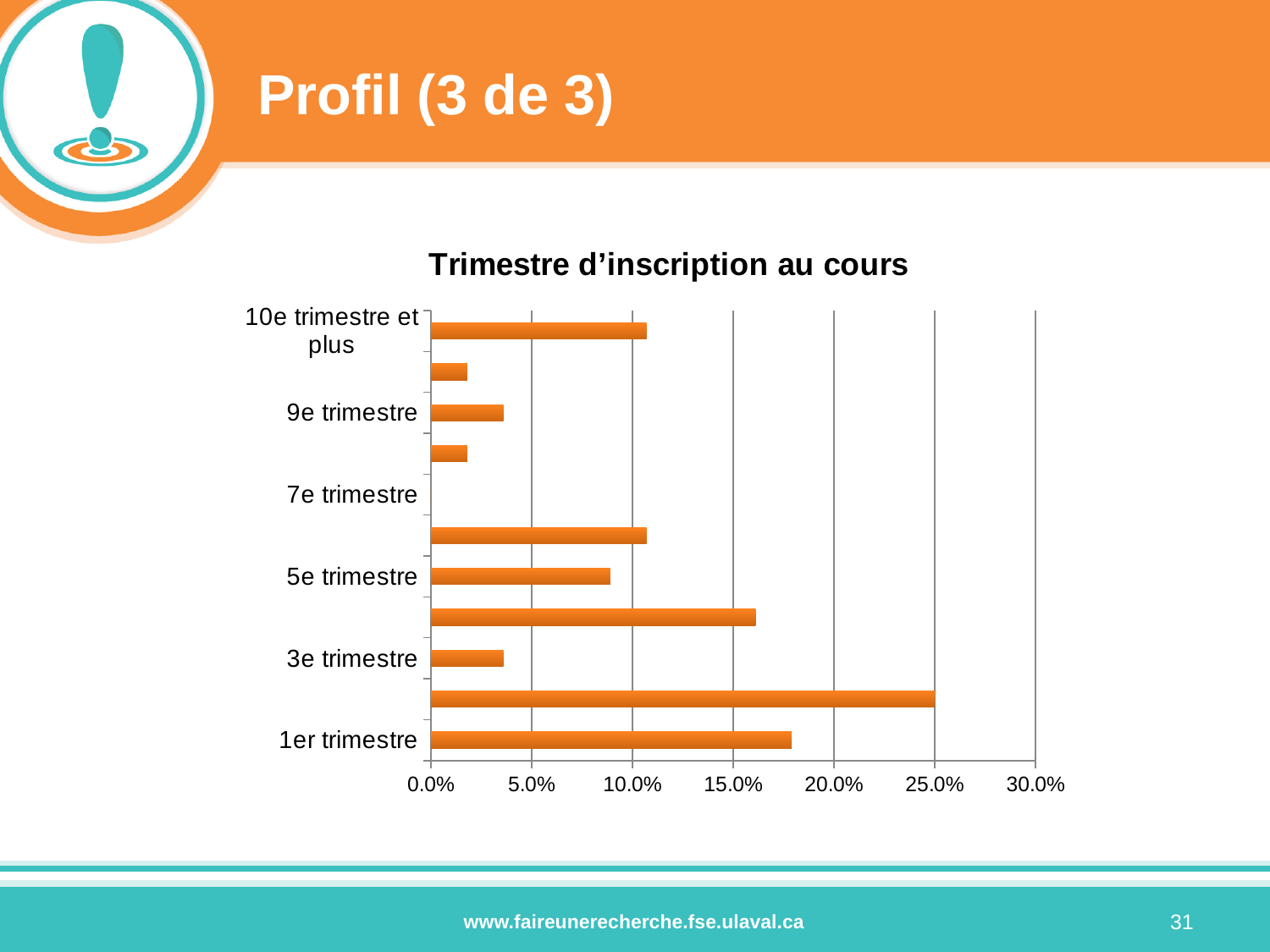
Is the value for 1er trimestre greater or less than 20.0%? less Is the value for 10e trimestre et plus greater or less than 15.0%? less Which is larger, the value for 1er trimestre or the value for 5e trimestre? 1er trimestre What is the title of the chart? Trimestre d’inscription au cours What kind of chart is shown on the slide? bar chart Which is larger, the value for 10e trimestre et plus or the value for 3e trimestre? 10e trimestre et plus Is the value for 9e trimestre greater or less than 5.0%? less Which category has the lowest value? 7e trimestre